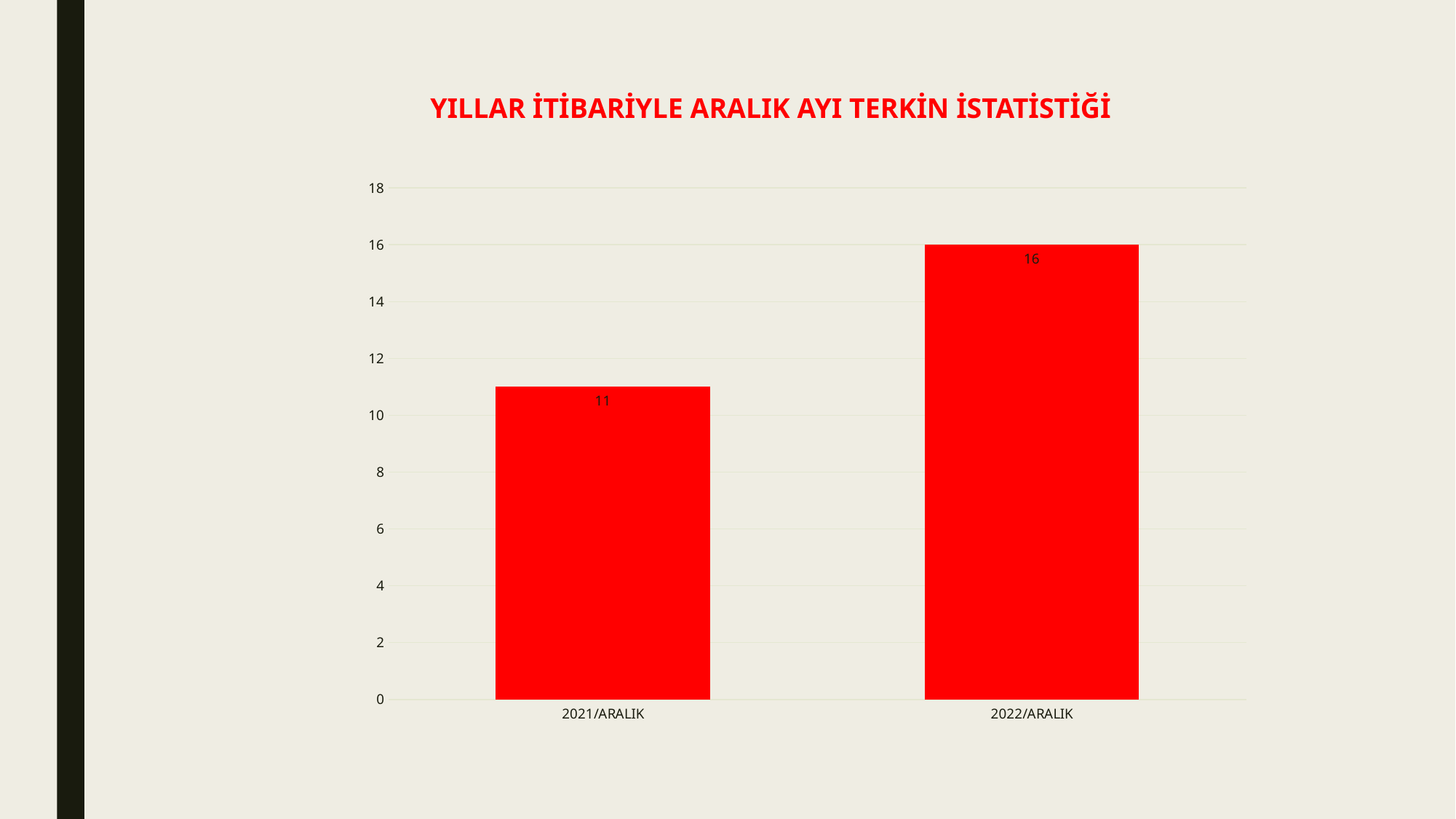
Do the values rise or fall from 2021/ARALIK to 2022/ARALIK? rise What kind of chart is shown on the slide? bar chart Is the value for 2021/ARALIK greater or less than 12? less What is the value for 2022/ARALIK? 16 How many categories are shown on the x axis? 2 Which is larger, the value for 2021/ARALIK or the value for 2022/ARALIK? 2022/ARALIK What is the difference between the values for 2022/ARALIK and 2021/ARALIK? 5 What is the title of the chart? YILLAR İTİBARİYLE ARALIK AYI TERKİN İSTATİSTİĞİ Which category has the highest value? 2022/ARALIK Is the value for 2022/ARALIK greater or less than 14? greater What is the value for 2021/ARALIK? 11 Which category has the lowest value? 2021/ARALIK